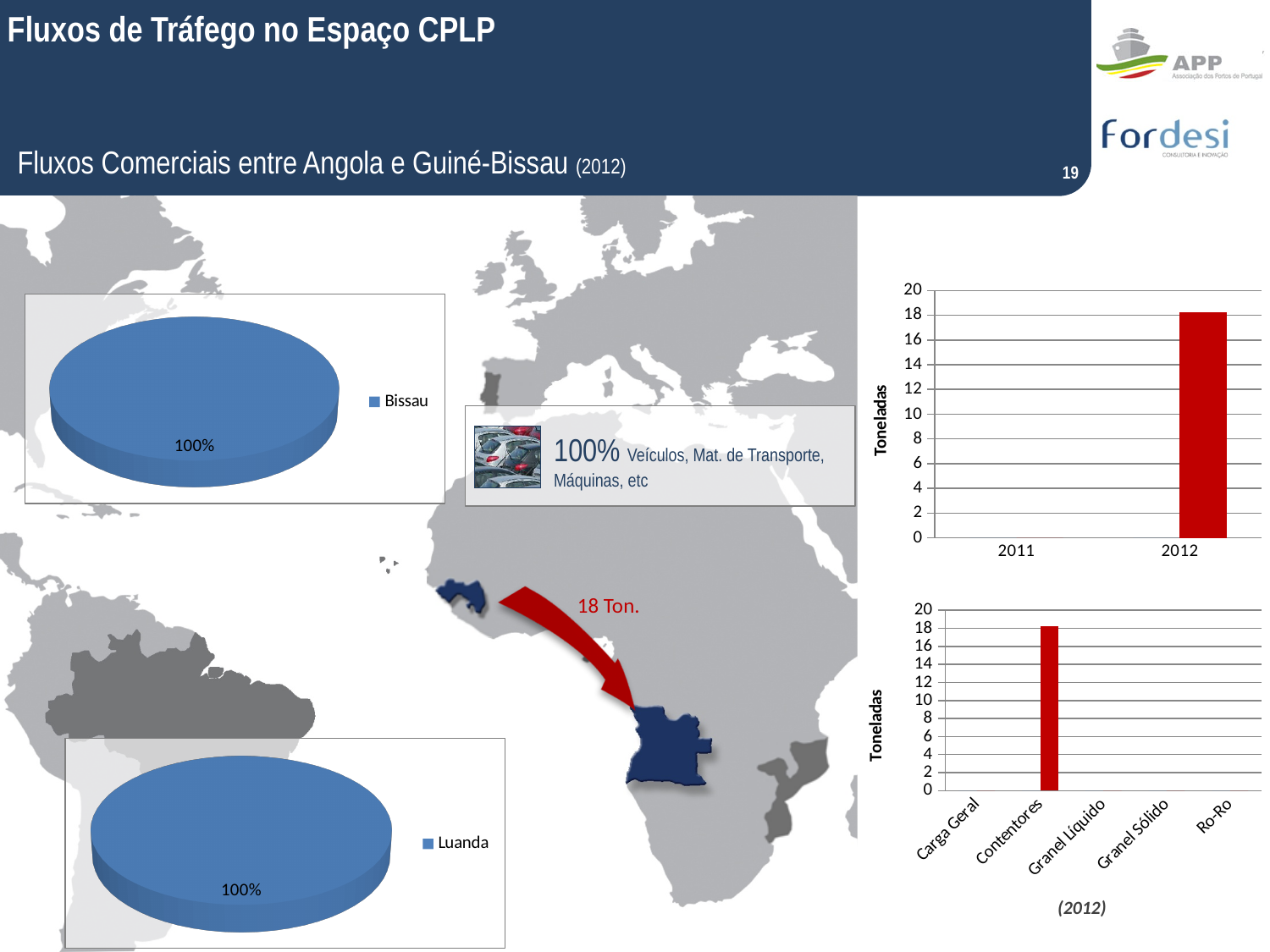
In the bottom-right bar chart with cargo types on the x axis, is the value for Contentores greater or less than 14? greater In the top-left pie chart, what share does the Bissau slice represent? 100% What kind of chart is the top-left chart with the Bissau legend entry? pie chart In the bottom-right bar chart with cargo types on the x axis, how many categories are shown on the x axis? 5 In the bottom-right bar chart with cargo types on the x axis, which is larger, the value for Contentores or the value for Ro-Ro? Contentores In the top-right bar chart with years on the x axis, which year has the highest value? 2012 What kind of chart is the top-right chart with the years 2011 and 2012 on the x axis? bar chart In the bottom-left pie chart, what share does the Luanda slice represent? 100% In the top-right bar chart with years on the x axis, is the value for 2012 greater or less than 16? greater In the top-right bar chart with years on the x axis, how many categories are shown on the x axis? 2 In the top-right bar chart with years on the x axis, what is the label of the y axis? Toneladas In the bottom-right bar chart with cargo types on the x axis, which category has the highest value? Contentores